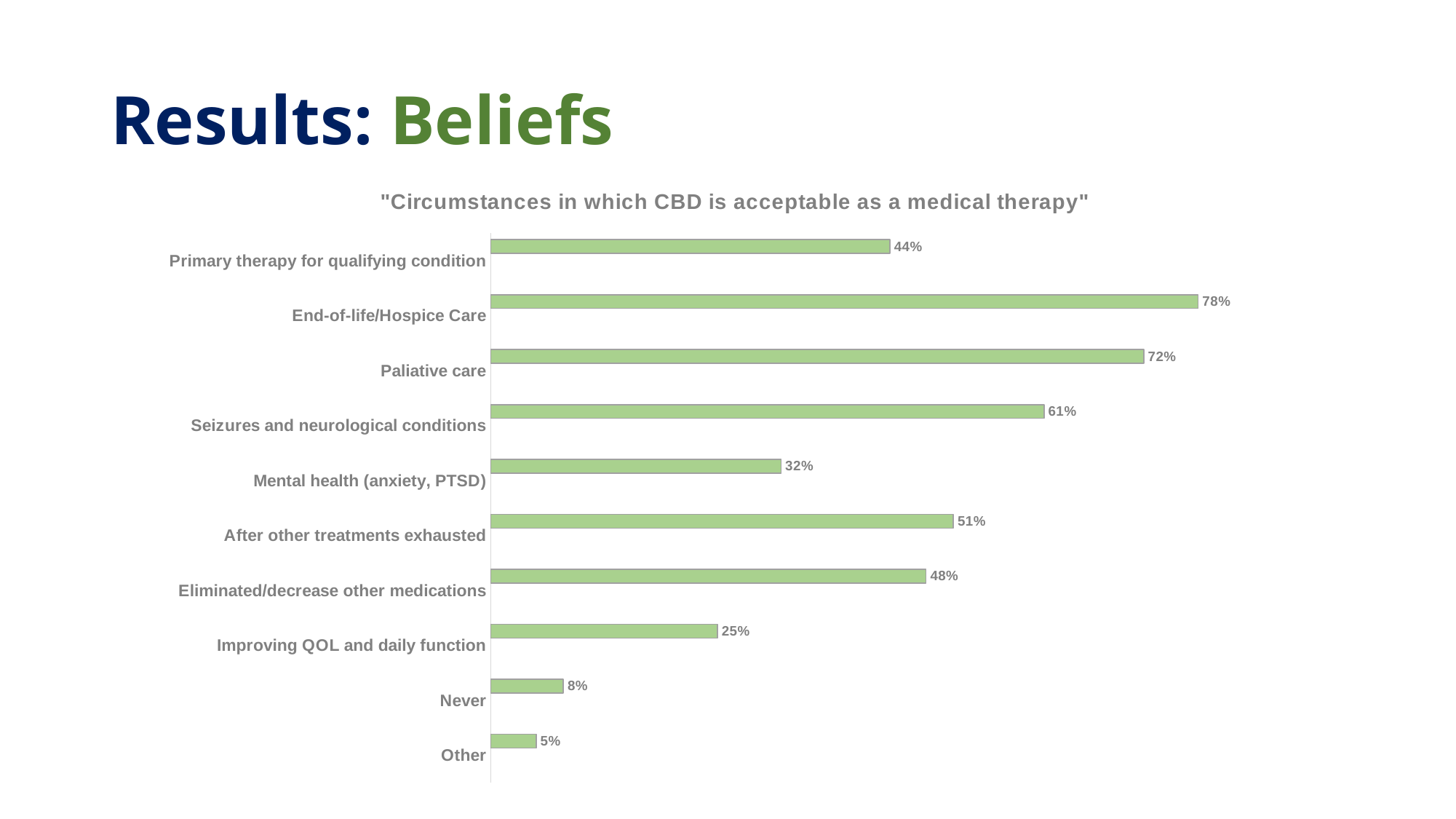
Which category has the lowest value? Other What colour are the bars in the chart? Green What is the value for Mental health (anxiety, PTSD)? 32% Which category has the highest value? End-of-life/Hospice Care What percentage is shown for End-of-life/Hospice Care? 78% What is the difference between the values for Primary therapy for qualifying condition and Improving QOL and daily function? 19% What percentage is shown for Never? 8% What is the difference between the values for Paliative care and Seizures and neurological conditions? 11% Which is larger, the value for After other treatments exhausted or the value for Eliminated/decrease other medications? After other treatments exhausted What kind of chart is shown on the slide? Bar chart What is the title of the chart? "Circumstances in which CBD is acceptable as a medical therapy" How many categories are shown in the chart? 10